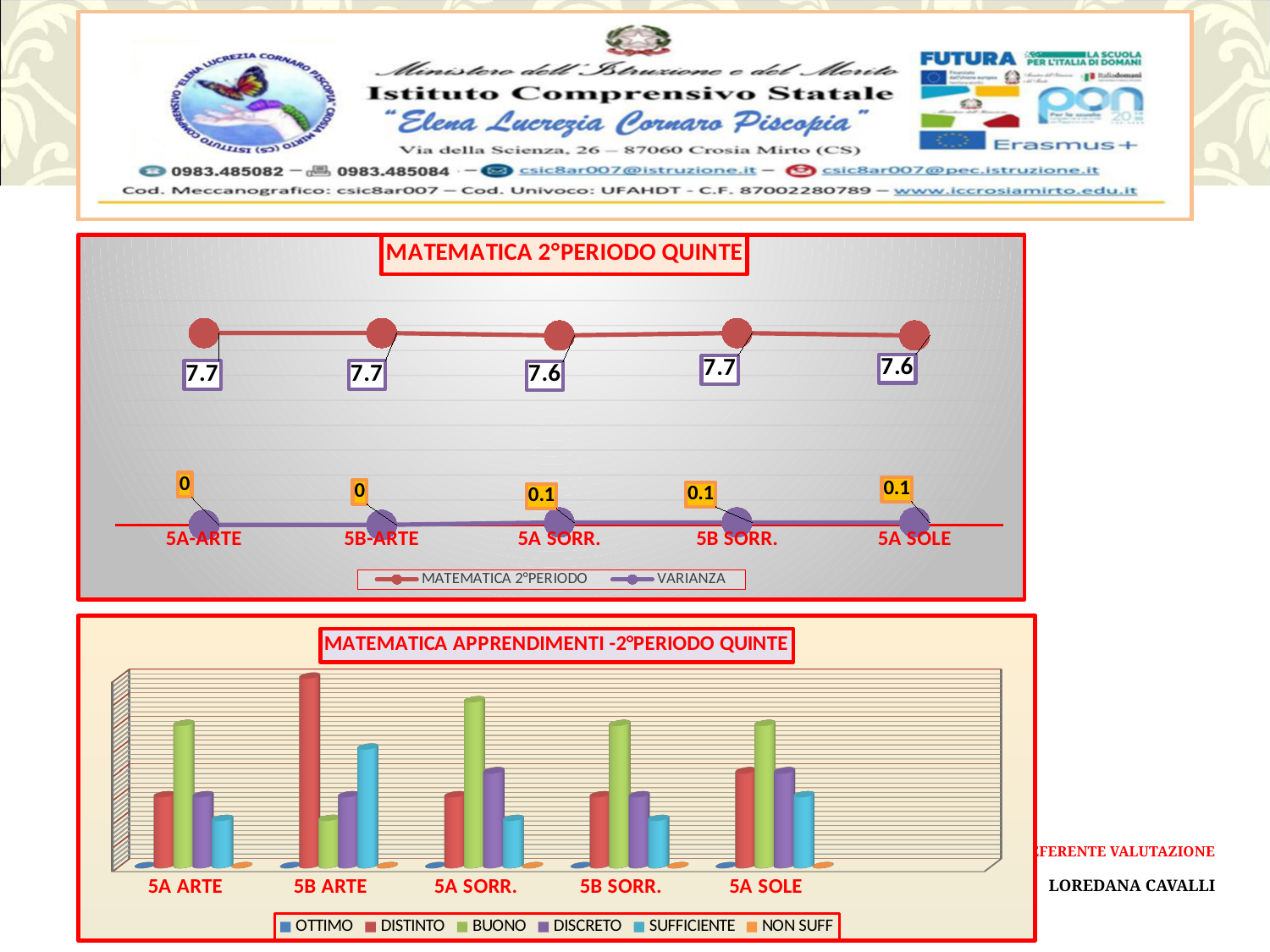
In the chart titled MATEMATICA 2°PERIODO QUINTE, what is the VARIANZA value for 5B-ARTE? 0 In the chart titled MATEMATICA APPRENDIMENTI -2°PERIODO QUINTE, how many series does the legend list? 6 In the chart titled MATEMATICA 2°PERIODO QUINTE, what is the MATEMATICA 2°PERIODO value for 5A SOLE? 7.6 What kind of chart is the one titled MATEMATICA APPRENDIMENTI -2°PERIODO QUINTE? bar chart In the chart titled MATEMATICA 2°PERIODO QUINTE, what is the MATEMATICA 2°PERIODO value for 5A-ARTE? 7.7 In the chart titled MATEMATICA 2°PERIODO QUINTE, how many categories are shown on the x axis? 5 In the chart titled MATEMATICA APPRENDIMENTI -2°PERIODO QUINTE, which category has the tallest DISTINTO bar? 5B ARTE In the chart titled MATEMATICA 2°PERIODO QUINTE, what is the VARIANZA value for 5B SORR.? 0.1 In the chart titled MATEMATICA APPRENDIMENTI -2°PERIODO QUINTE, for 5A ARTE, is the BUONO bar or the DISTINTO bar taller? BUONO In the chart titled MATEMATICA 2°PERIODO QUINTE, how many series does the legend list? 2 In the chart titled MATEMATICA 2°PERIODO QUINTE, what is the difference between the MATEMATICA 2°PERIODO values for 5B-ARTE and 5A SORR.? 0.1 What kind of chart is the one titled MATEMATICA 2°PERIODO QUINTE? line chart